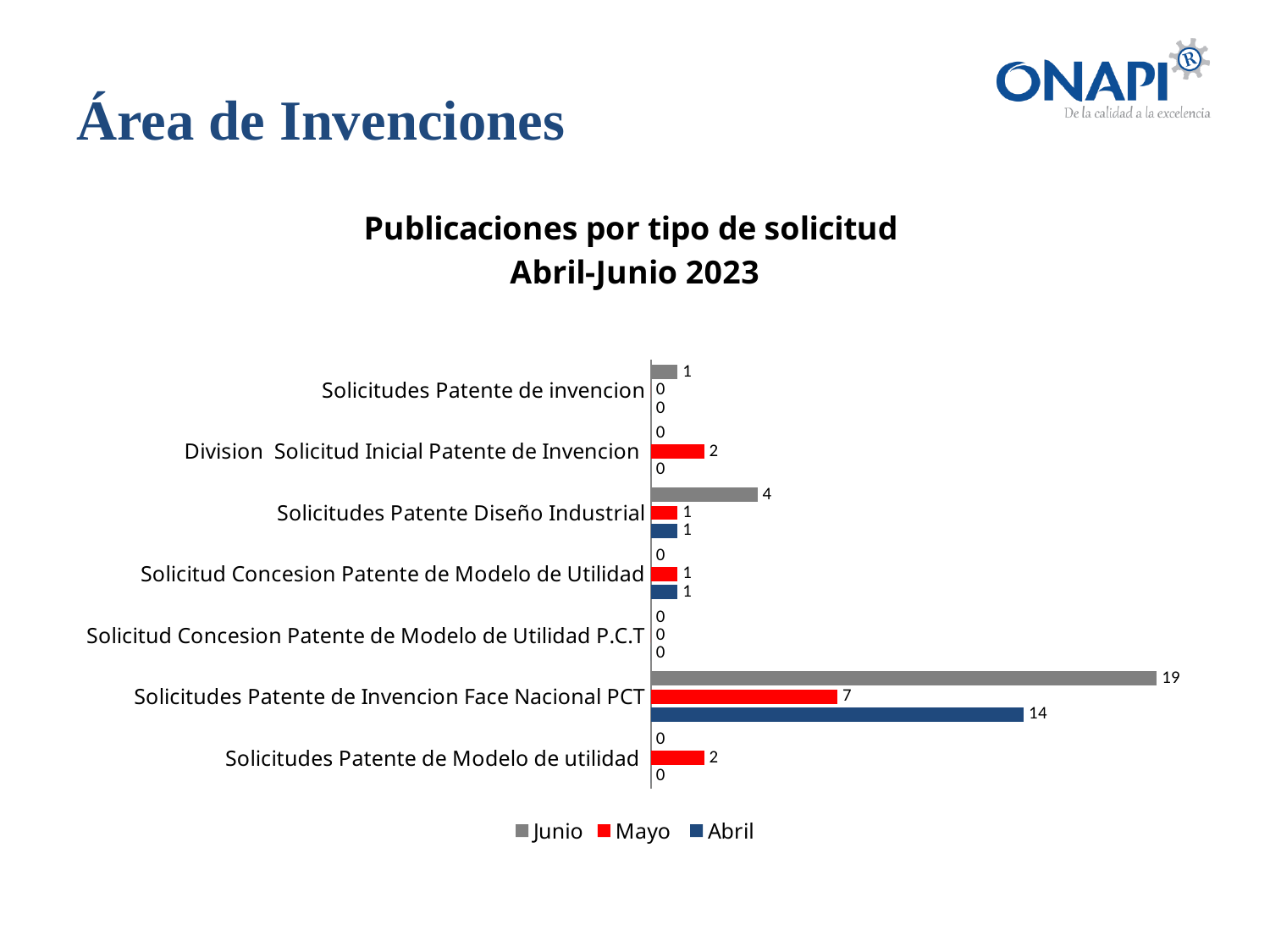
How many series does the legend list? 3 What is the Abril value for Solicitudes Patente de Invencion Face Nacional PCT? 14 What is the Mayo value for Division Solicitud Inicial Patente de Invencion? 2 What is the title of the chart? Publicaciones por tipo de solicitud Abril-Junio 2023 What is the difference between the Abril and Mayo values for Solicitudes Patente de Invencion Face Nacional PCT? 7 What kind of chart is shown on the slide? Bar chart Which is larger for Solicitudes Patente de Invencion Face Nacional PCT, the Abril value or the Mayo value? Abril What is the difference between the Junio and Mayo values for Solicitudes Patente de Invencion Face Nacional PCT? 12 How many categories are shown on the chart? 7 Which category has the highest Junio value? Solicitudes Patente de Invencion Face Nacional PCT What is the Junio value for Solicitudes Patente Diseño Industrial? 4 What is the Junio value for Solicitudes Patente de Invencion Face Nacional PCT? 19